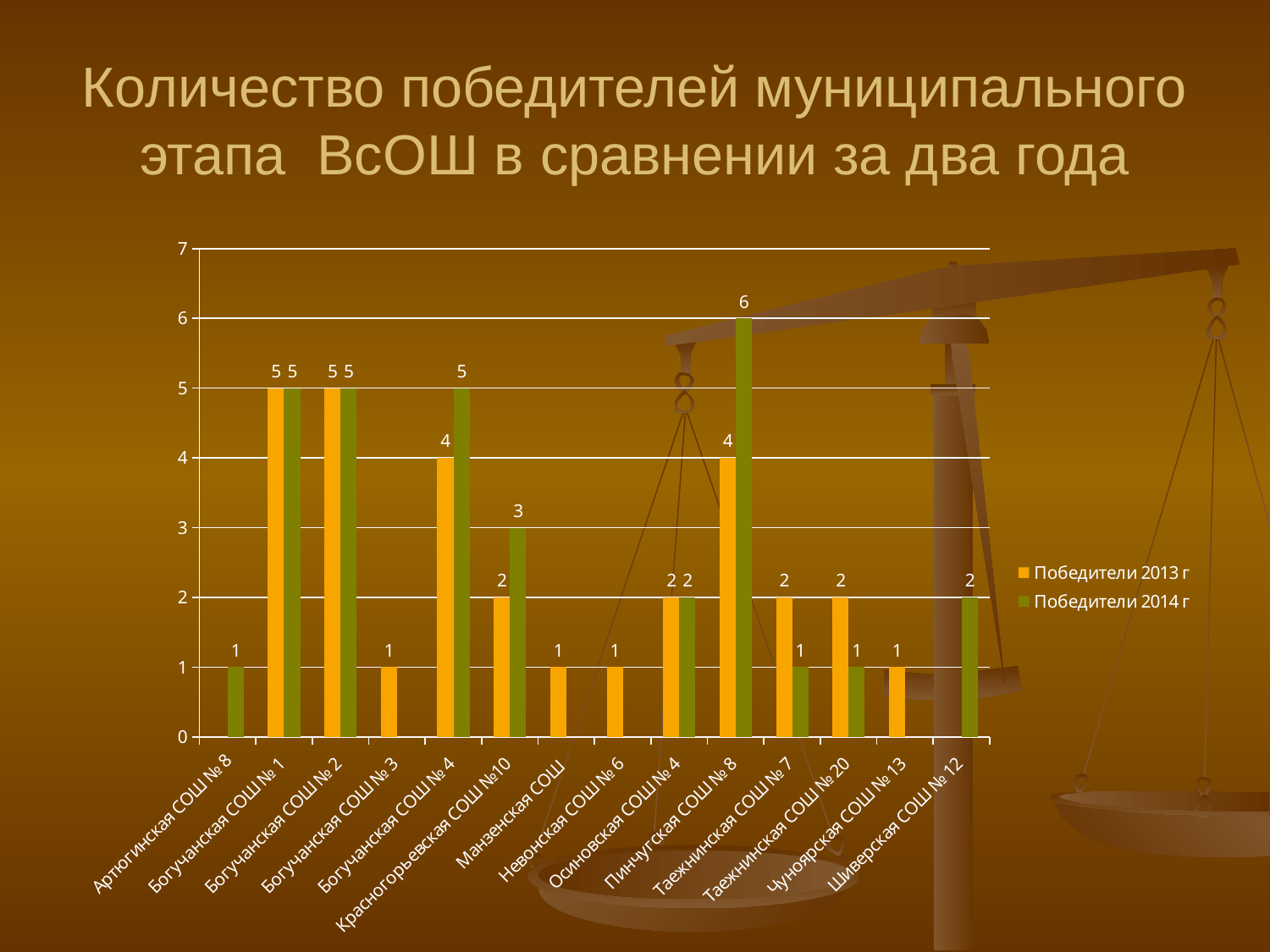
Which school has the highest value in the Победители 2014 г series? Пинчугская СОШ № 8 What is the value for Шиверская СОШ № 12 in the Победители 2014 г series? 2 What is the value for Пинчугская СОШ № 8 in the Победители 2014 г series? 6 Which is larger for Таежнинская СОШ № 7: the Победители 2013 г value or the Победители 2014 г value? Победители 2013 г What colour are the bars for the Победители 2013 г series? orange How many series does the legend list? 2 What is the value for Красногорьевская СОШ №10 in the Победители 2014 г series? 3 What kind of chart is shown on the slide? bar chart How many schools (categories) are shown on the x axis? 14 What is the value for Богучанская СОШ № 4 in the Победители 2013 г series? 4 Which is larger for Богучанская СОШ № 4: the Победители 2013 г value or the Победители 2014 г value? Победители 2014 г What is the difference between the 2014 and 2013 values for Пинчугская СОШ № 8? 2